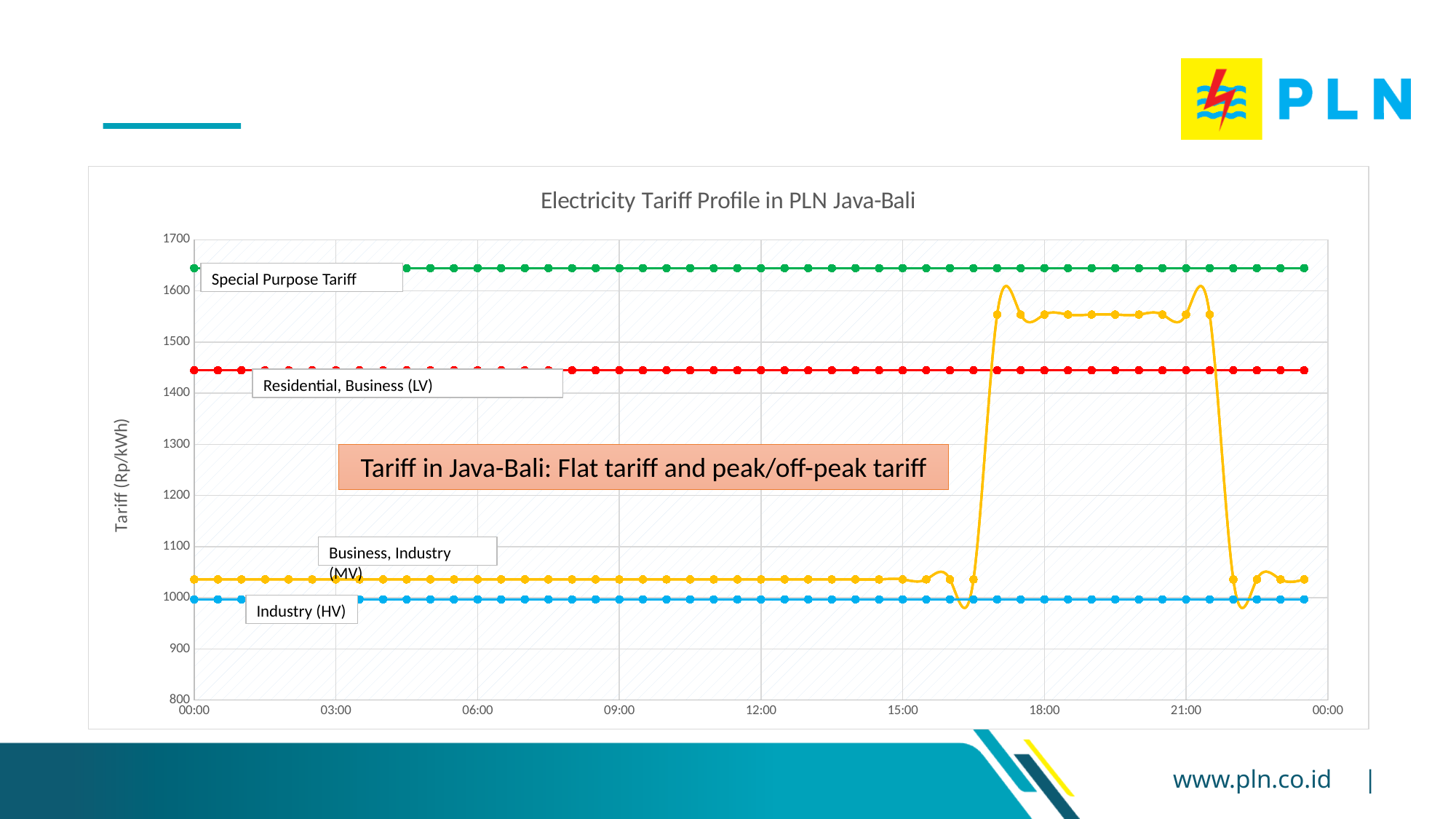
What kind of chart is shown on the slide? line chart Which tariff series has the lowest values across the whole day? Industry (HV) Is the value for Industry (HV) greater or less than 1100? less Which tariff series has the highest values across the whole day? Special Purpose Tariff What is the label of the vertical axis? Tariff (Rp/kWh) Is the value for Residential, Business (LV) greater or less than 1400? greater Is the value for Special Purpose Tariff greater or less than 1600? greater What is the title of the chart? Electricity Tariff Profile in PLN Java-Bali Which series is higher at 18:00: Business, Industry (MV) or Residential, Business (LV)? Business, Industry (MV)